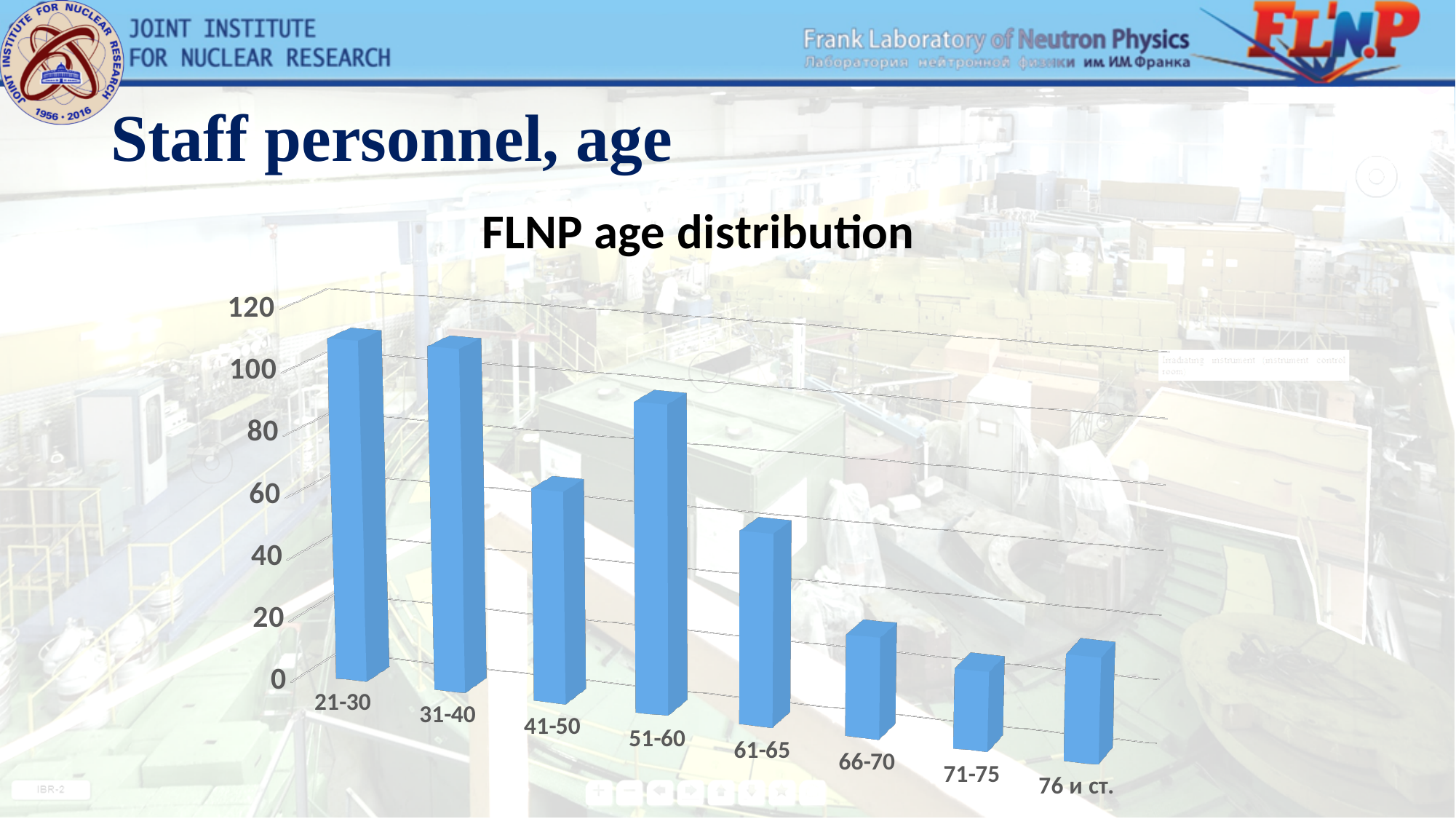
Which age group has the larger value, 31-40 or 51-60? 31-40 Is the value for the 41-50 age group greater or less than 80? less What kind of chart is shown on the slide? bar chart Is the value for the 66-70 age group greater or less than 40? less Which age group has the larger value, 21-30 or 41-50? 21-30 How many age categories are shown on the x axis of the chart? 8 Is the value for the 51-60 age group greater or less than 60? greater Which age group has the larger value, 51-60 or 61-65? 51-60 What is the title of the chart? FLNP age distribution